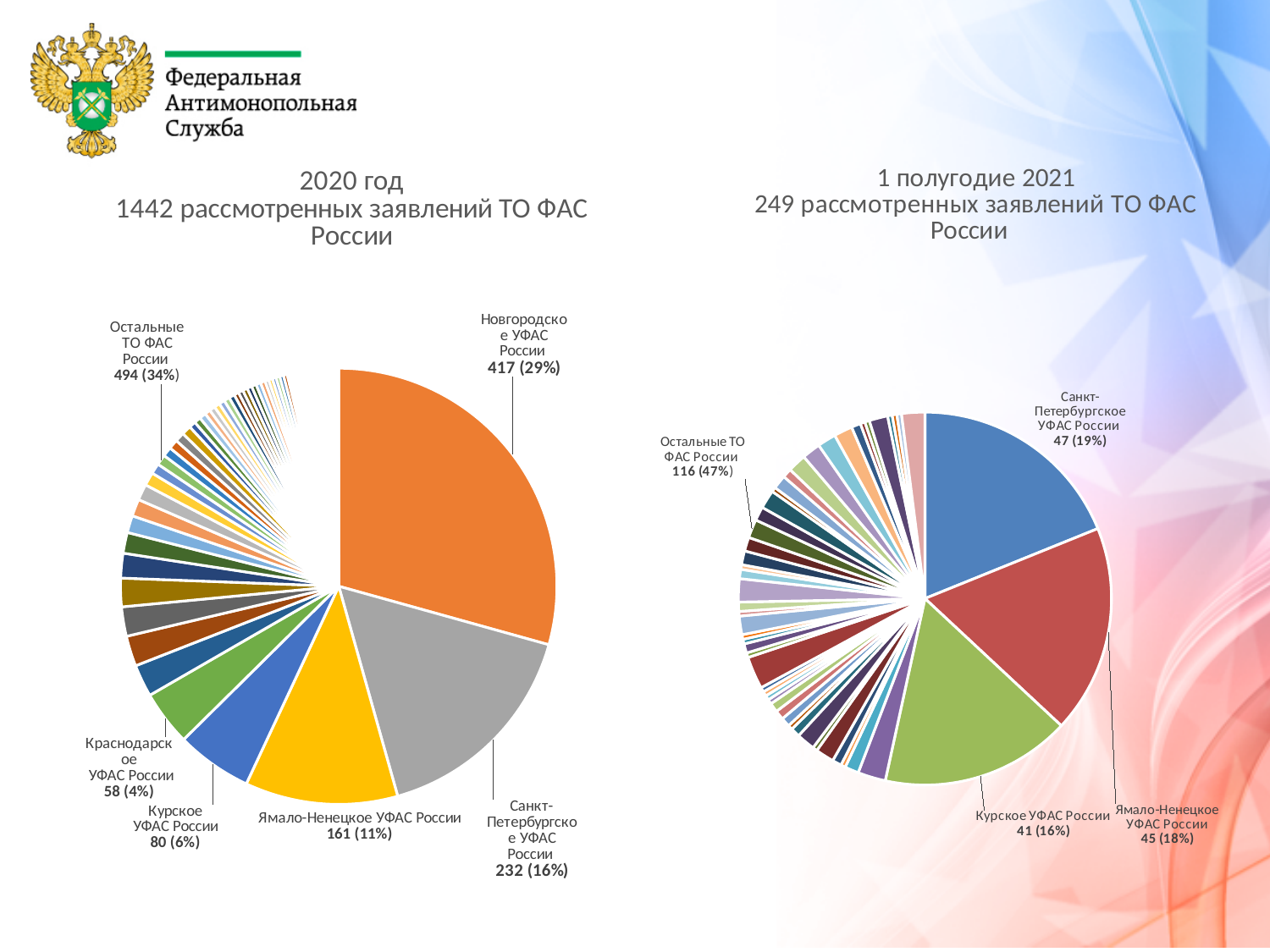
In the 2020 pie chart, what is the difference between the values for Курское УФАС России and Краснодарское УФАС России? 22 In the 1 полугодие 2021 pie chart, what share of the pie does Остальные ТО ФАС России hold? 47% In the 2020 pie chart, what value is shown for Новгородское УФАС России? 417 (29%) In the 2020 pie chart, what value is shown for Санкт-Петербургское УФАС России? 232 (16%) In the 2020 pie chart, which labelled slice is the smallest? Краснодарское УФАС России In the 2020 pie chart, which is larger: Санкт-Петербургское УФАС России or Ямало-Ненецкое УФАС России? Санкт-Петербургское УФАС России In the 1 полугодие 2021 pie chart, what value is shown for Санкт-Петербургское УФАС России? 47 (19%) In the 2020 pie chart, which individual labelled УФАС (excluding Остальные ТО ФАС России) has the largest slice? Новгородское УФАС России In the 1 полугодие 2021 pie chart, what is the difference between the values for Ямало-Ненецкое УФАС России and Курское УФАС России? 4 In the 2020 pie chart, what share of the pie does Ямало-Ненецкое УФАС России hold? 11% What type of chart is used on the left side of the slide for 2020? Pie chart According to the title of the right-hand chart, how many applications were reviewed in 1 полугодие 2021? 249